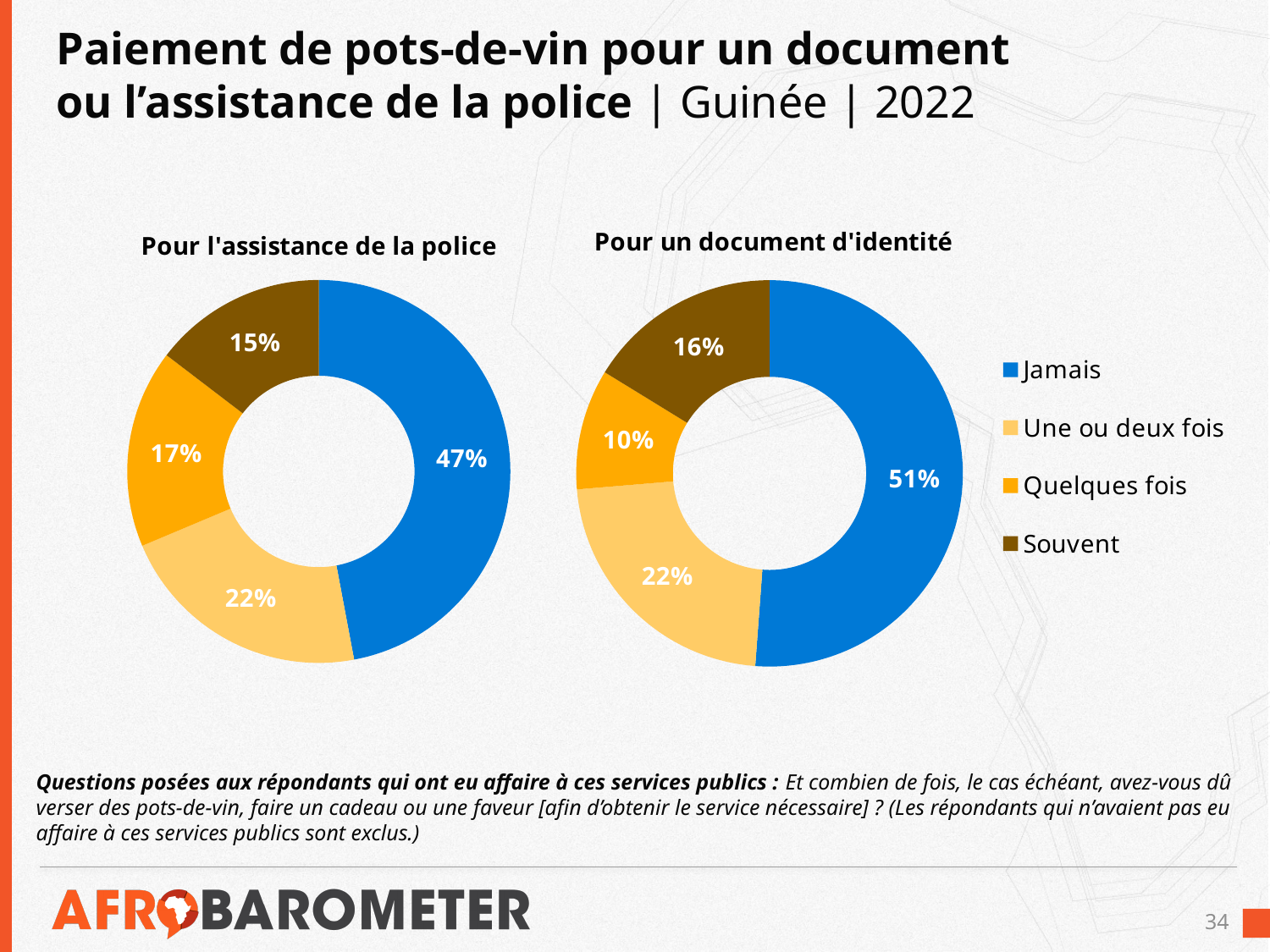
In the 'Pour l'assistance de la police' chart, what percentage is shown for 'Jamais'? 47% In the 'Pour un document d'identité' chart, which category has the smallest share? Quelques fois What is the difference between the 'Jamais' share in the 'Pour un document d'identité' chart and the 'Jamais' share in the 'Pour l'assistance de la police' chart? 4 percentage points In the 'Pour un document d'identité' chart, what percentage is shown for 'Jamais'? 51% In the 'Pour l'assistance de la police' chart, what percentage is shown for 'Quelques fois'? 17% In the 'Pour un document d'identité' chart, what percentage is shown for 'Souvent'? 16% In the 'Pour l'assistance de la police' chart, which category has the largest share? Jamais Which is larger: 'Quelques fois' in the 'Pour l'assistance de la police' chart or 'Quelques fois' in the 'Pour un document d'identité' chart? Pour l'assistance de la police Which colour represents 'Souvent' in the legend? Brown What kind of chart is used on this slide? Donut (pie) chart How many categories does the legend list? 4 In the 'Pour l'assistance de la police' chart, what is the combined share of 'Une ou deux fois' and 'Quelques fois'? 39%